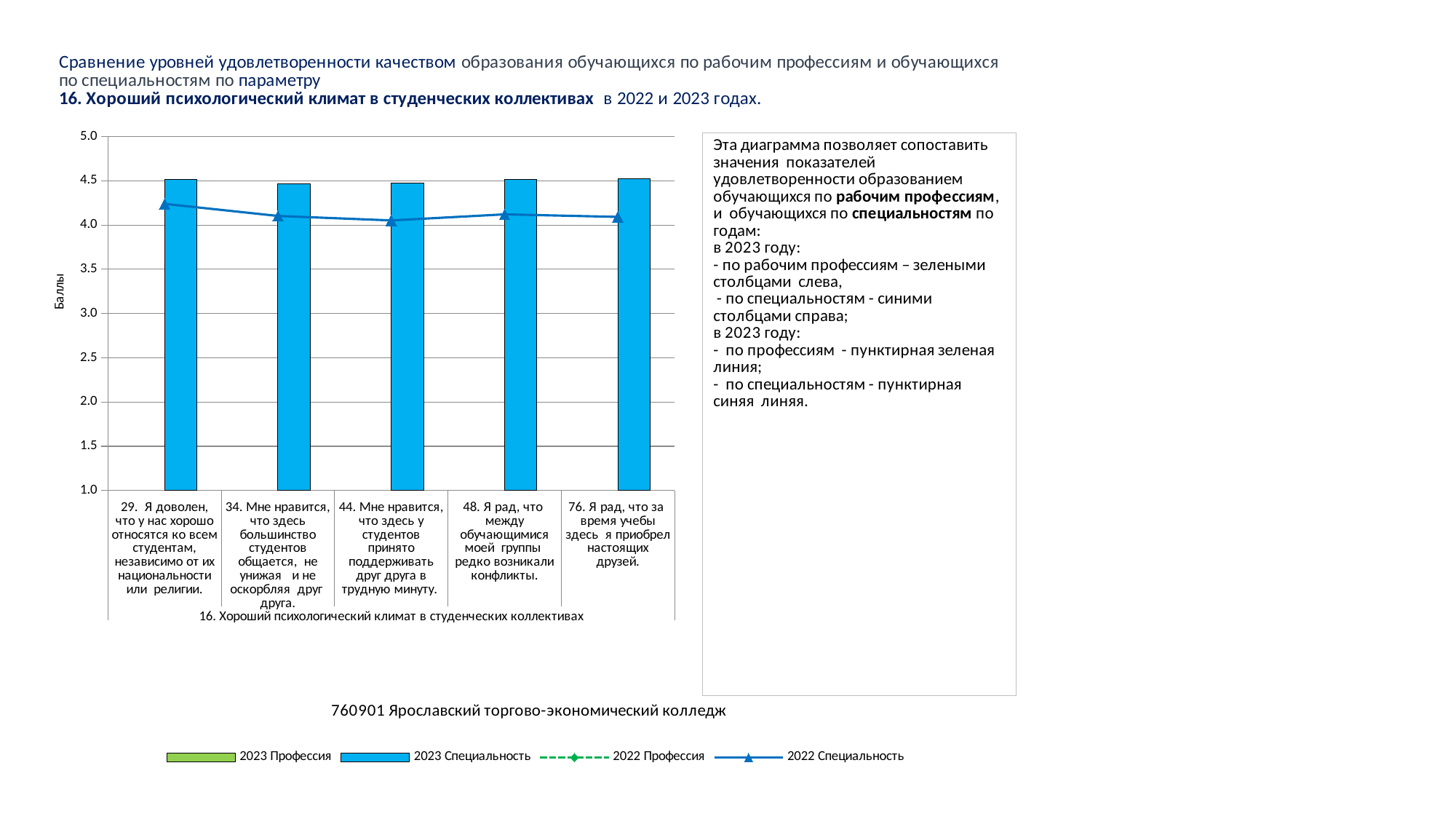
What title is shown below the chart's x axis categories? 16. Хороший психологический климат в студенческих коллективах Is the 2022 Специальность line value for statement 29 greater or less than 4.0? greater Is the 2023 Специальность bar for statement 34 greater or less than 5.0? less Is the 2023 Специальность bar for statement 29 greater or less than 4.0? greater How many categories (statements) are shown along the x axis of the chart? 5 What is the label of the vertical axis of the chart? Баллы What kind of chart is shown on the slide? A bar chart combined with a line chart Which statement has the highest value on the 2022 Специальность line? 29. Я доволен, что у нас хорошо относятся ко всем студентам, независимо от их национальности или религии. How many series does the chart legend list? 4 For statement 48, which is larger: the 2023 Специальность bar or the 2022 Специальность line value? The 2023 Специальность bar